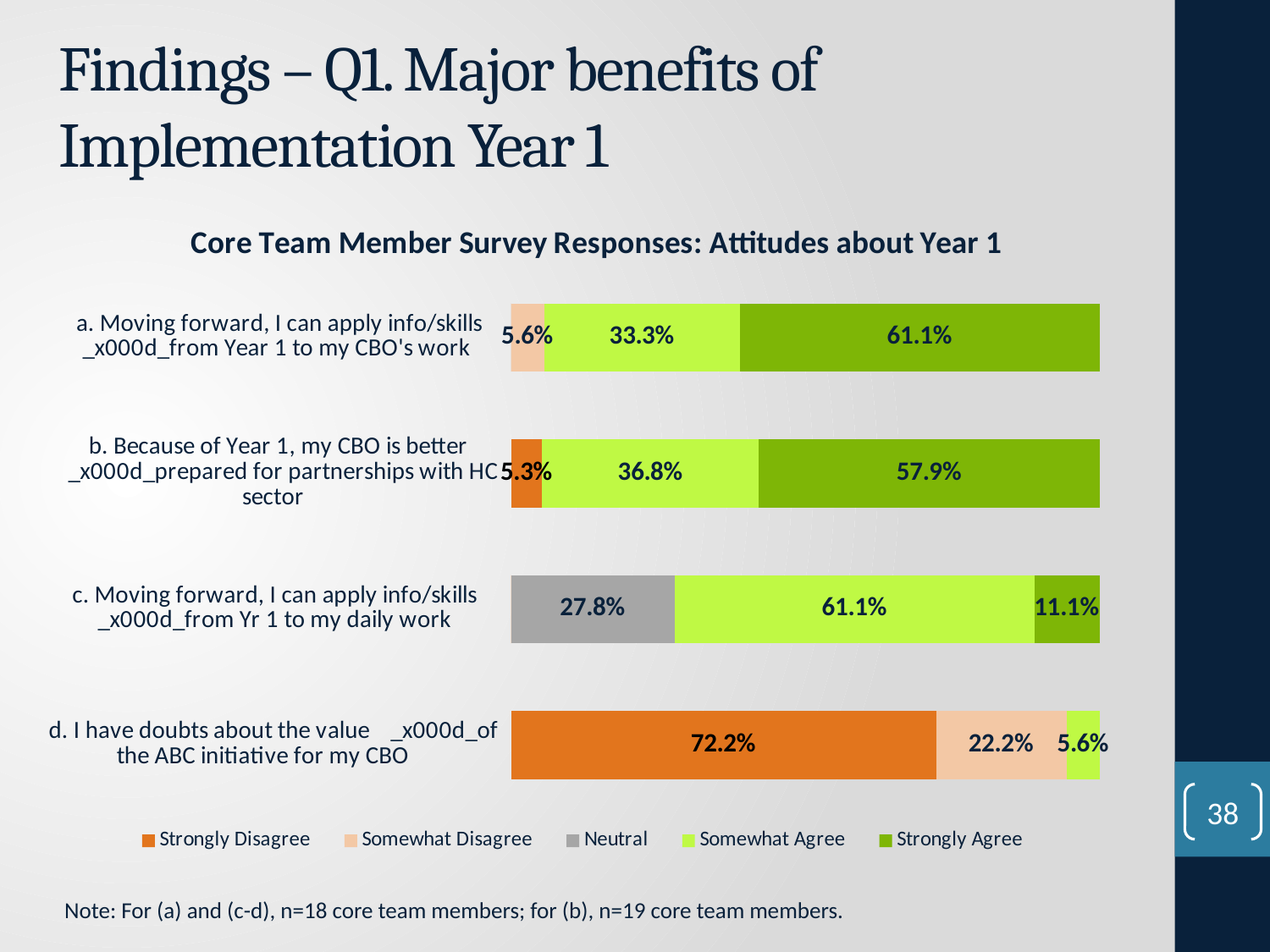
What is the Neutral percentage for statement c, 'Moving forward, I can apply info/skills from Yr 1 to my daily work'? 27.8% What is the Strongly Agree percentage for statement a, 'Moving forward, I can apply info/skills from Year 1 to my CBO's work'? 61.1% What kind of chart is shown on the slide? Stacked bar chart How many series does the legend list? 5 Which statement has the lowest Strongly Agree percentage among those with a Strongly Agree segment? c. Moving forward, I can apply info/skills from Yr 1 to my daily work What is the difference between the Strongly Agree percentages for statement a and statement b? 3.2% What is the Somewhat Agree percentage for statement b, 'Because of Year 1, my CBO is better prepared for partnerships with HC sector'? 36.8% How many statements (categories) are plotted in the chart? 4 Which statement has the highest Strongly Agree percentage? a. Moving forward, I can apply info/skills from Year 1 to my CBO's work What is the Strongly Disagree percentage for statement d, 'I have doubts about the value of the ABC initiative for my CBO'? 72.2% What is the title of the chart? Core Team Member Survey Responses: Attitudes about Year 1 Is the Somewhat Agree percentage larger for statement c or statement a? Statement c